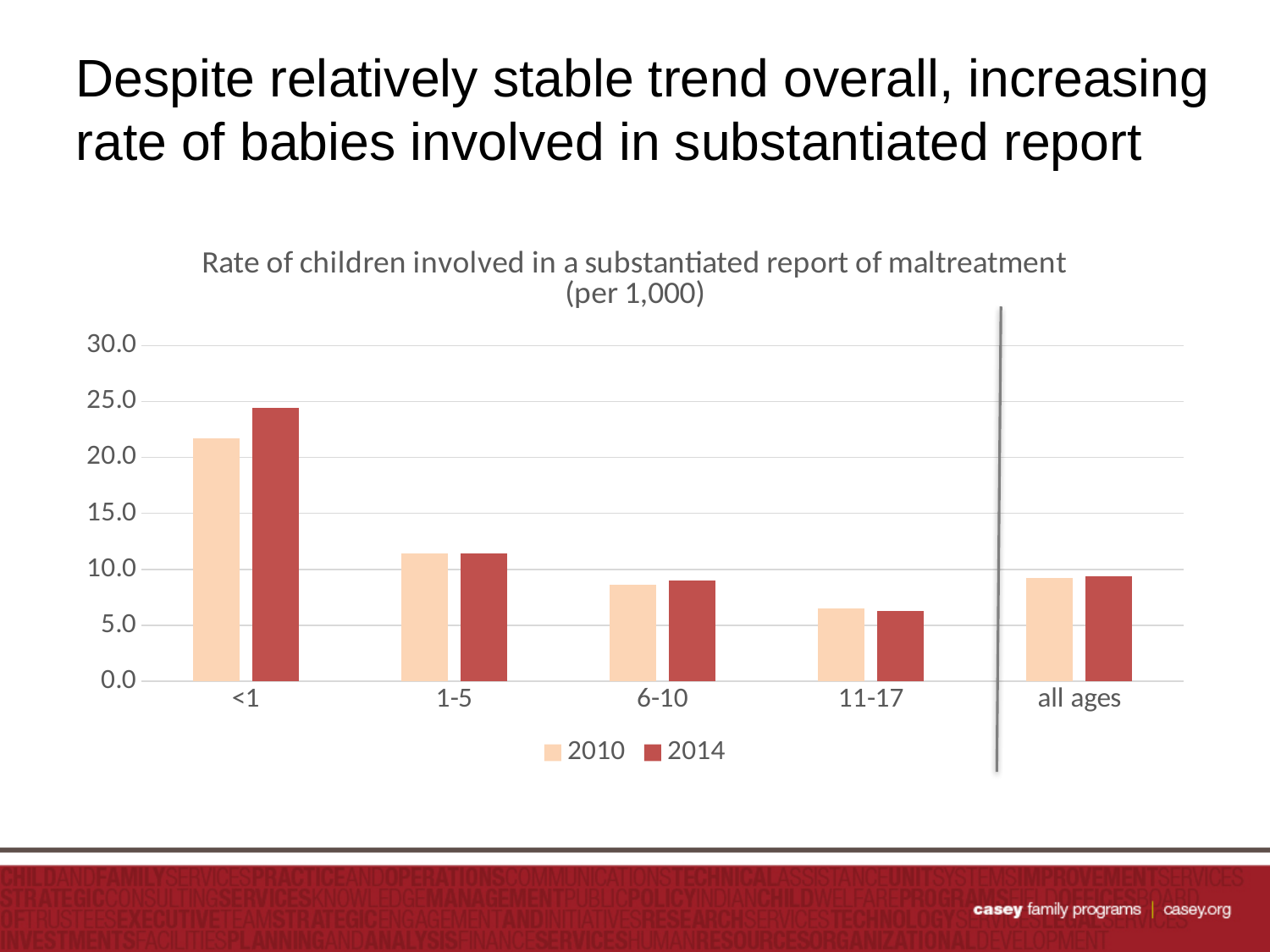
For the <1 age group, which year has the larger rate, 2010 or 2014? 2014 Do the 2014 rates rise or fall moving from the <1 group to the 11-17 group? fall How many age categories are shown on the x axis? 5 Is the 2014 value for the <1 age group greater or less than 20.0? greater Which age category has the lowest 2014 rate? 11-17 How many series does the legend list? 2 What are the two entries in the chart legend? 2010 and 2014 Is the 2014 value for the 6-10 age group greater or less than 15.0? less Is the 2010 value for the 11-17 age group greater or less than 10.0? less What kind of chart is shown on the slide? bar chart Which age category has the highest 2014 rate? <1